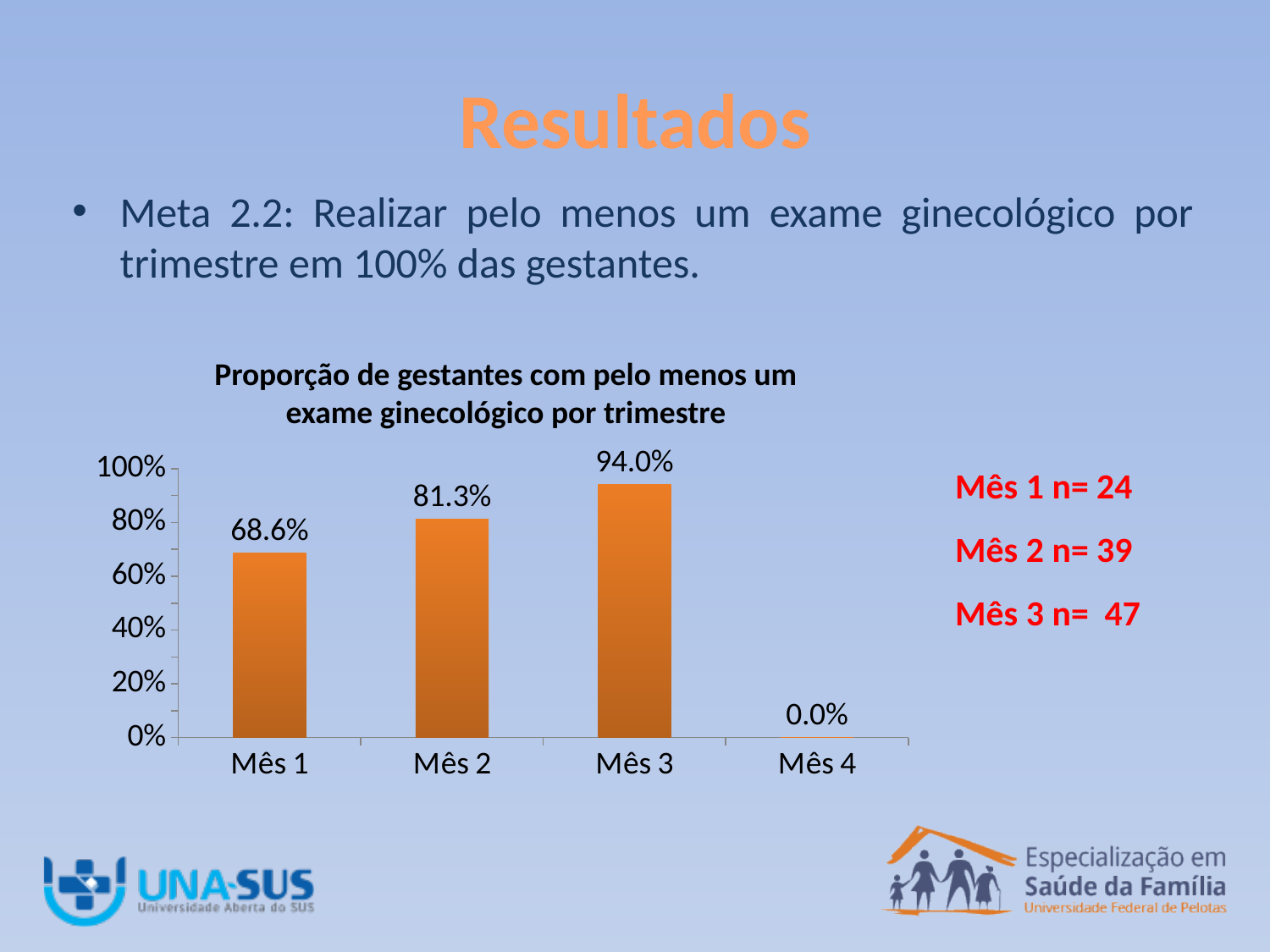
Which month has the lowest value? Mês 4 What is the value for Mês 4? 0.0% What kind of chart is shown on the slide? Bar chart How many months are shown on the x axis? 4 What is the value for Mês 1? 68.6% What is the title of the chart? Proporção de gestantes com pelo menos um exame ginecológico por trimestre Which month has the highest value? Mês 3 What is the value for Mês 3? 94.0% Which is larger, the value for Mês 2 or the value for Mês 1? Mês 2 What is the value for Mês 2? 81.3% What is the difference between the values for Mês 3 and Mês 1? 25.4% Do the values rise or fall from Mês 1 to Mês 3? Rise